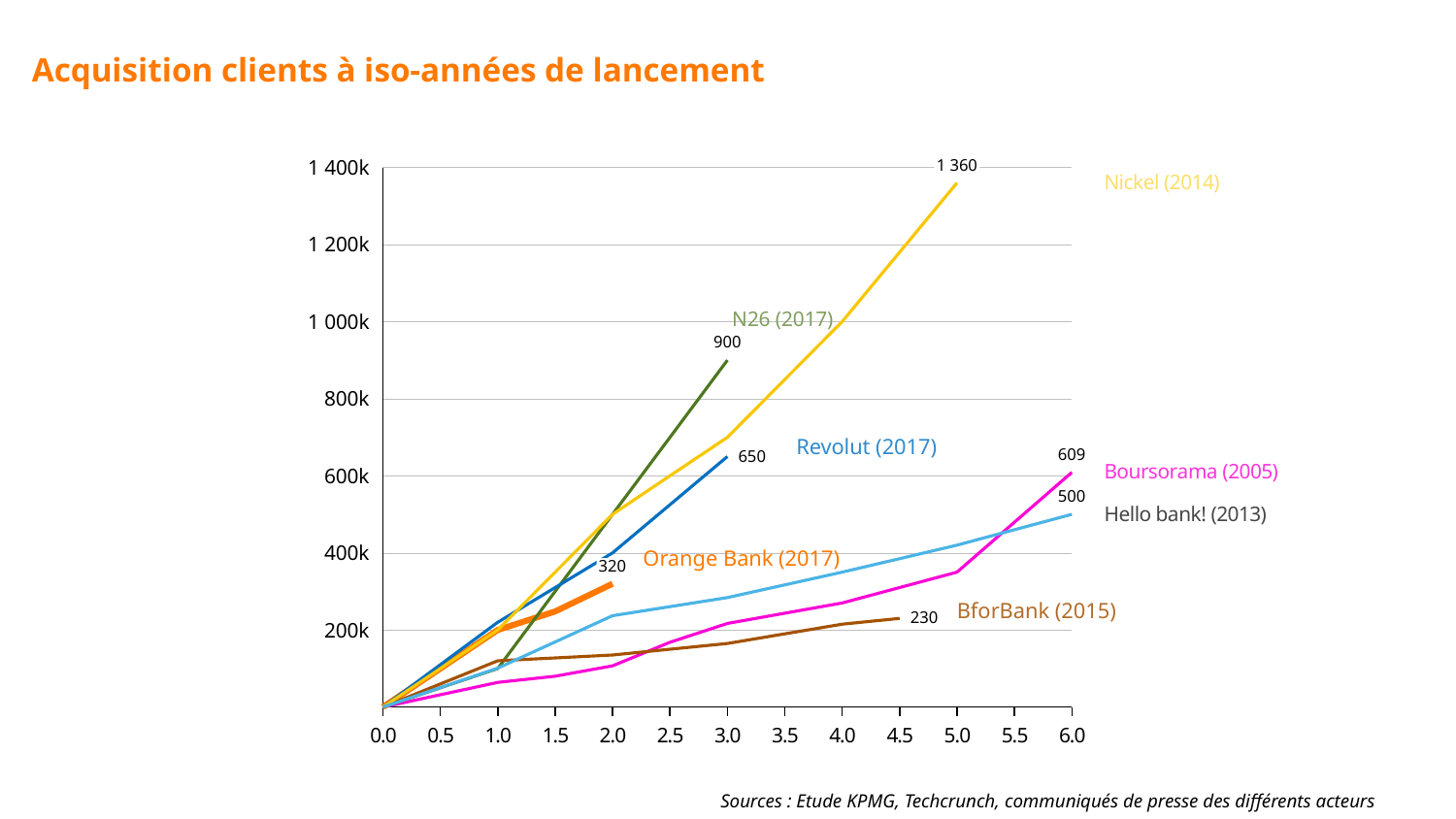
What is the final labelled value for Boursorama (2005)? 609 What is the difference between the final labelled values of Boursorama (2005) and Hello bank! (2013)? 109 What is the final labelled value for Revolut (2017)? 650 Which series has the lowest final labelled value? BforBank (2015) How many series (banks) are plotted on the chart? 7 What is the final labelled value for BforBank (2015)? 230 Which series reaches the highest labelled value on the chart? Nickel (2014) What is the final labelled value for N26 (2017)? 900 Which has a higher final labelled value, N26 (2017) or Revolut (2017)? N26 (2017) What is the final labelled value for Nickel (2014)? 1 360 What type of chart is shown on the slide? Line chart Is the value for Hello bank! (2013) at year 4.0 greater or less than 400k? less